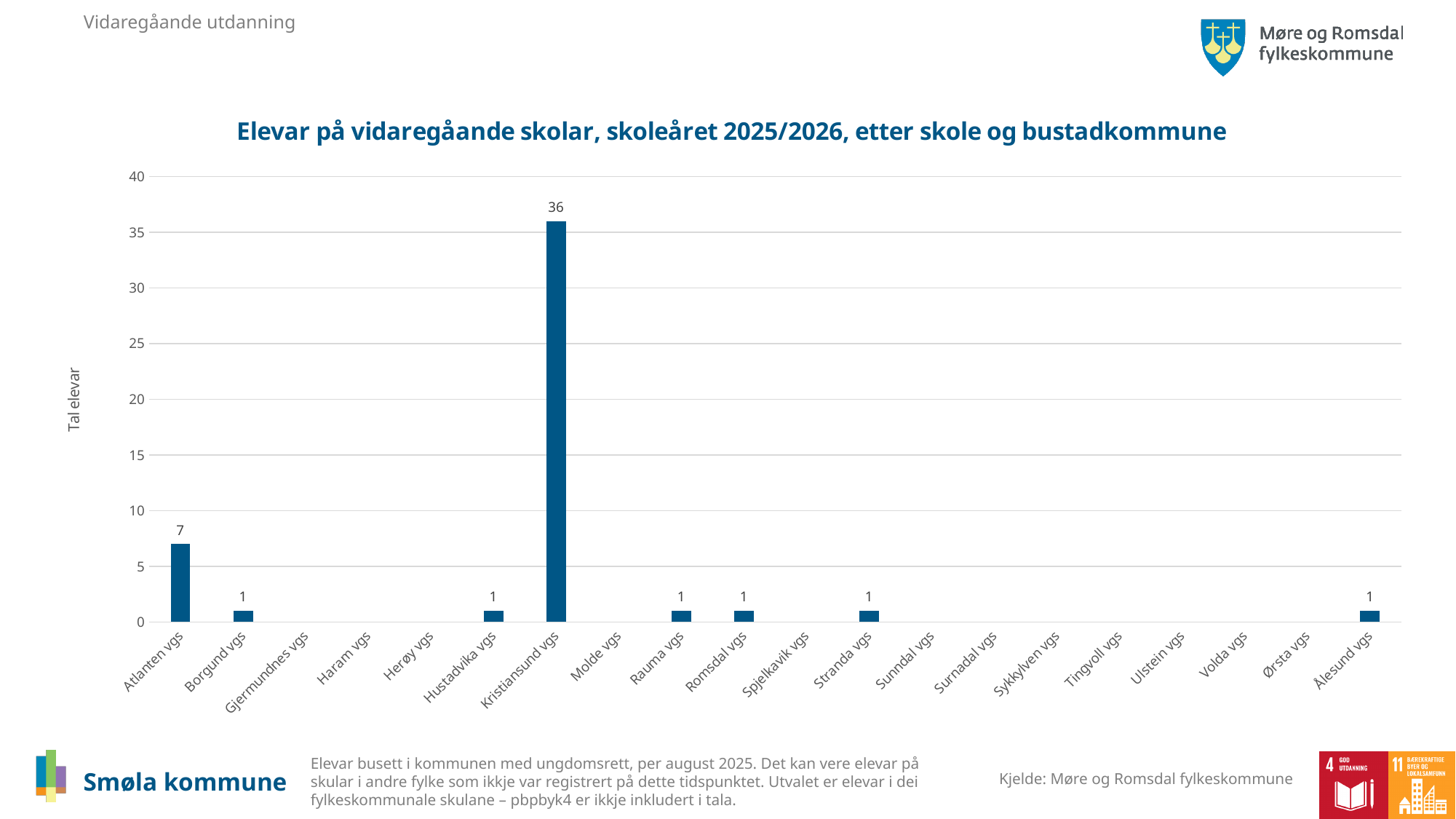
What is the difference between the values for Atlanten vgs and Rauma vgs? 6 Which is larger, the value for Atlanten vgs or the value for Stranda vgs? Atlanten vgs What is the difference between the values for Kristiansund vgs and Atlanten vgs? 29 What is the value for Kristiansund vgs? 36 Which school has the highest number of students? Kristiansund vgs What is the label of the y axis? Tal elevar How many schools are listed on the x axis? 20 What is the value for Atlanten vgs? 7 What kind of chart is shown on the slide? bar chart What is the value for Borgund vgs? 1 Is the value for Kristiansund vgs greater or less than 35? greater What is the value for Ålesund vgs? 1